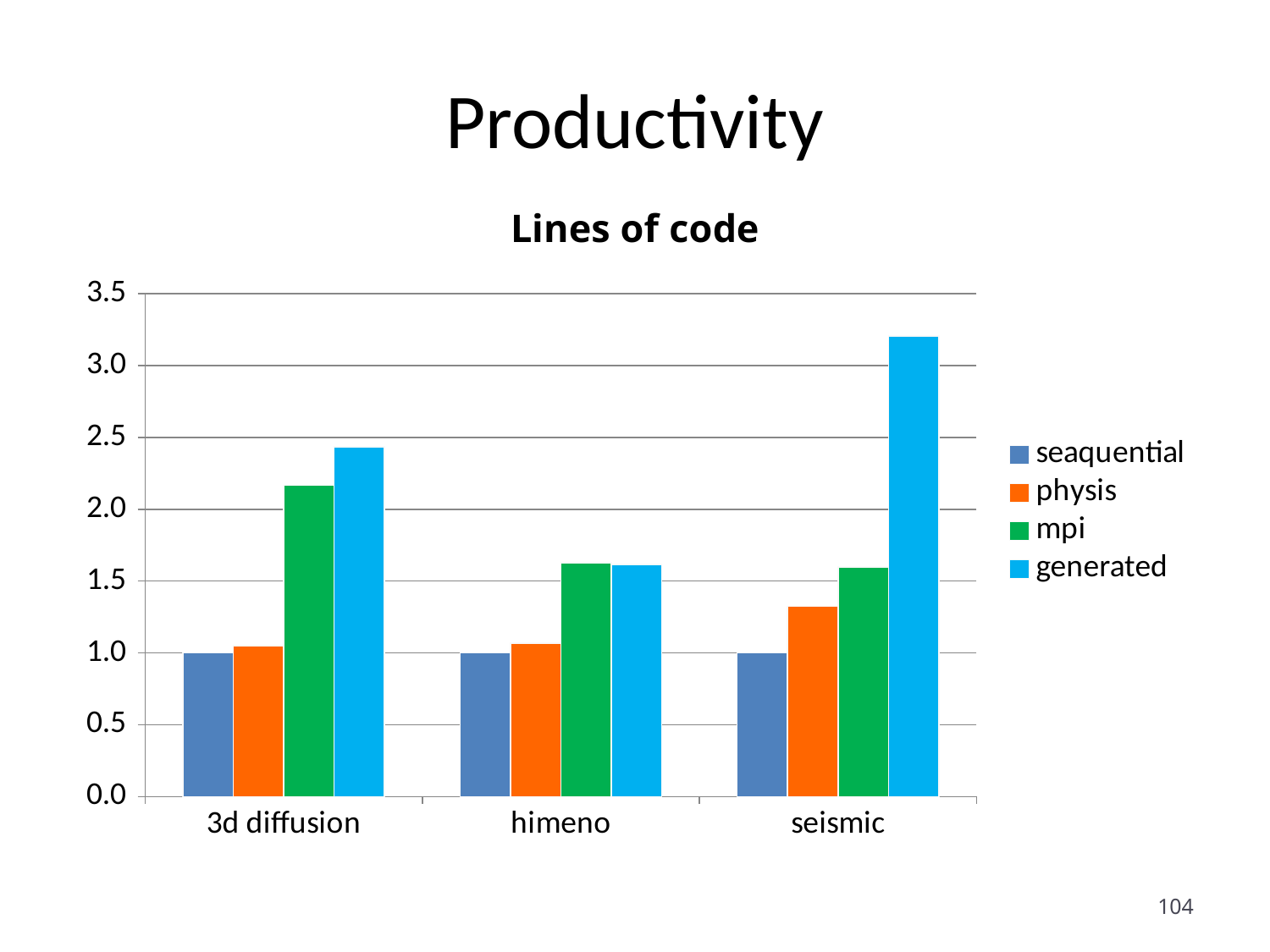
Is the value of the physis series for seismic greater or less than 1.5? less Is the value of the mpi series for 3d diffusion greater or less than 2.0? greater What kind of chart is shown on the slide? bar chart Which category has the highest value for the generated series? seismic Is the value of the generated series for seismic greater or less than 3.0? greater What is the value of the seaquential series for 3d diffusion? 1.0 How many series does the legend list? 4 For 3d diffusion, which is larger: the mpi value or the generated value? generated How many categories are shown on the x axis? 3 Which series has the lowest value for seismic? seaquential What is the title of the chart? Lines of code